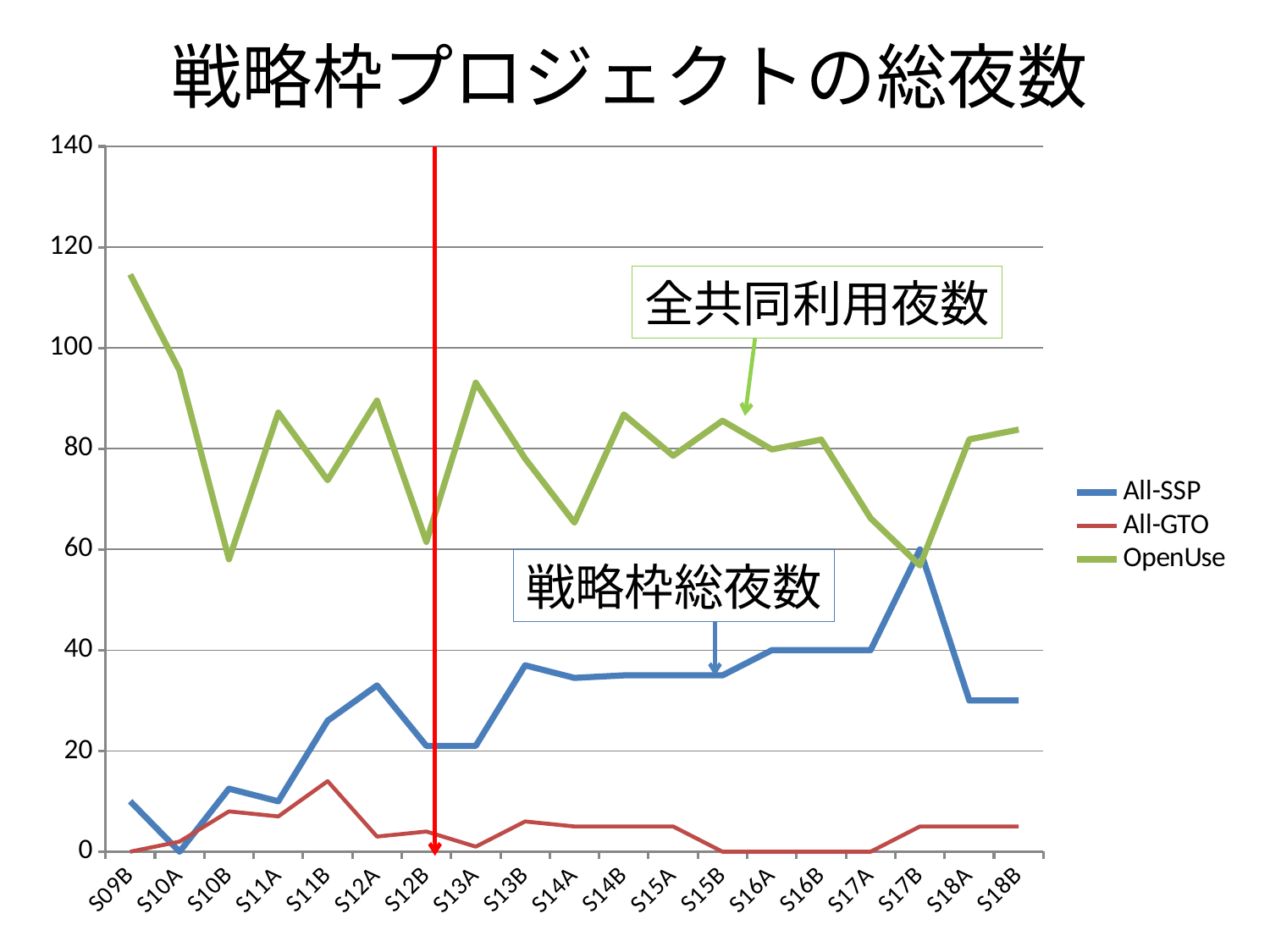
What kind of chart is shown on the slide? line chart Which semester has the highest OpenUse value? S09B Does the OpenUse line rise or fall from S09B to S10B? fall Which semester has the highest All-SSP value? S17B Is the OpenUse value for S10B greater or less than 60? less Is the All-SSP value for S18B greater or less than 40? less At S09B, which series has the larger value, OpenUse or All-SSP? OpenUse How many series does the legend list? 3 Is the OpenUse value for S09B greater or less than 100? greater How many semesters (categories) are shown along the x axis? 19 Which semester has the highest All-GTO value? S11B What is the title of the chart? 戦略枠プロジェクトの総夜数